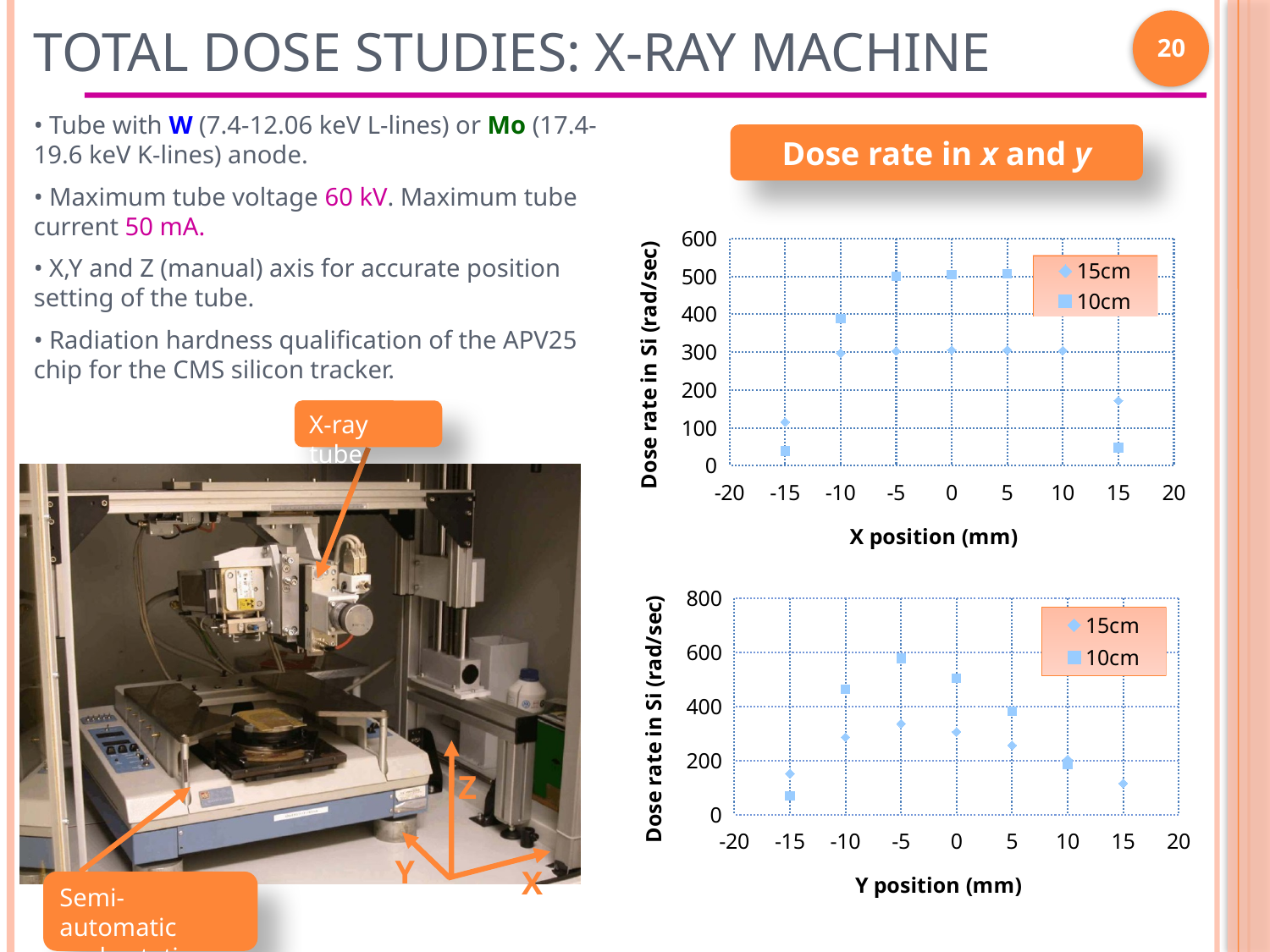
In the bottom chart (Y position), is the 10cm value at Y position -5 greater or less than 400? greater How many series does the legend of the bottom chart (Y position) list? 2 In the top chart (X position), is the 15cm value at X position -15 greater or less than 200? less What are the two legend entries in the top chart (X position)? 15cm and 10cm In the bottom chart (Y position), at which Y position does the 10cm series have its lowest dose rate? -15 In the top chart (X position), is the 10cm value at X position 0 greater or less than 400? greater What is the label of the vertical axis in the bottom chart (Y position)? Dose rate in Si (rad/sec) In the top chart (X position), at X position 0, which series has the higher dose rate, 15cm or 10cm? 10cm In the top chart (X position), at X position -15, which series has the higher dose rate, 15cm or 10cm? 15cm What kind of chart is the top chart with X position (mm) on the horizontal axis? scatter chart How many data points does the 15cm series have in the top chart (X position)? 7 In the bottom chart (Y position), at which Y position does the 10cm series reach its highest dose rate? -5